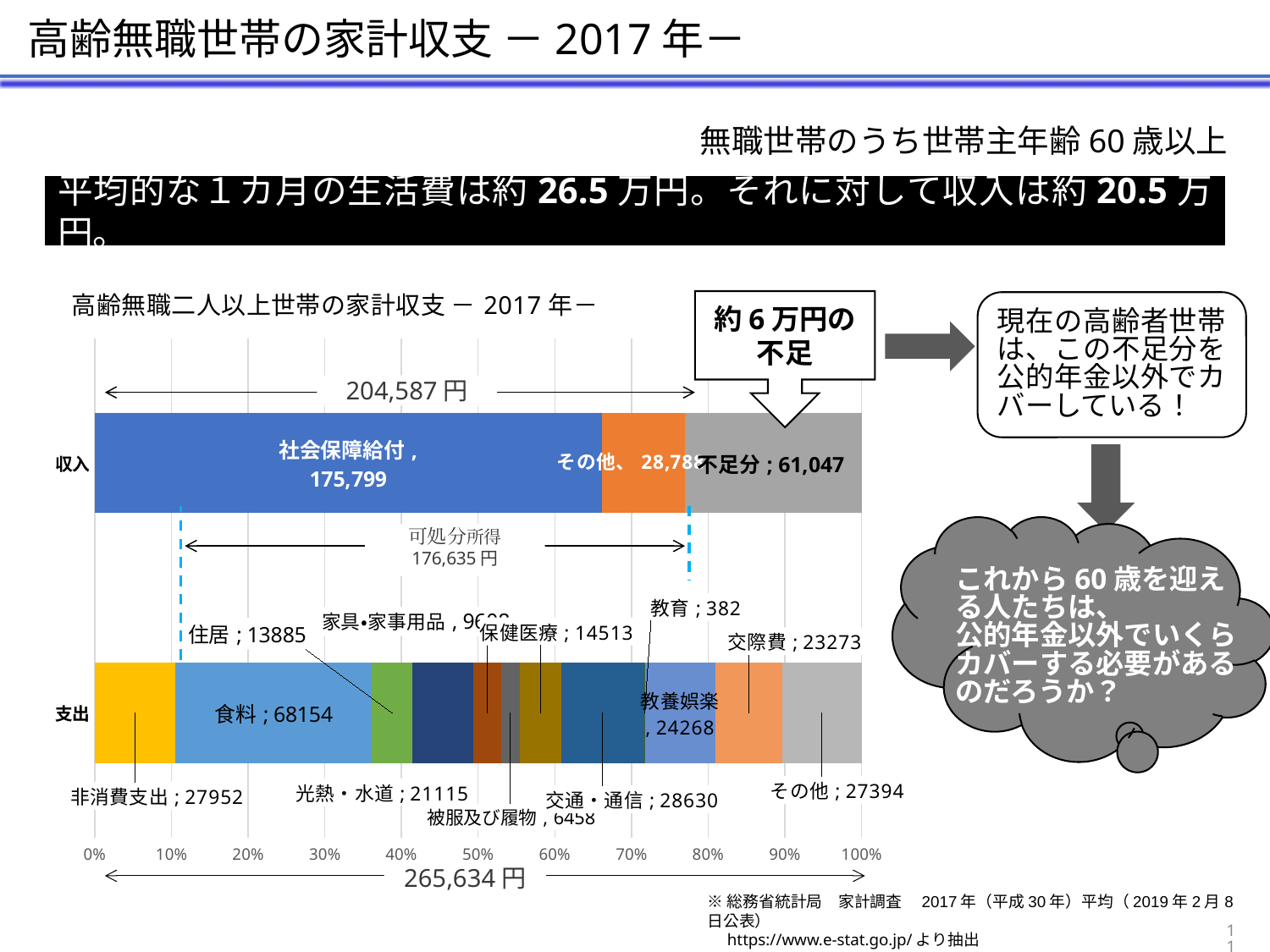
What is the difference between 交際費 and 光熱・水道 in the 支出 bar? 2158 What is the value of その他 in the 収入 bar? 28,788 How many bars (categories) does the chart have? 2 What kind of chart is shown on the slide? Stacked bar chart What is the value of 食料 in the 支出 bar? 68154 What is the value of 教育 in the 支出 bar? 382 What is the total of the 支出 bar as printed on the slide? 265,634 円 In the 支出 bar, which is larger: 交通・通信 or その他? 交通・通信 What is the value of 社会保障給付 in the 収入 bar? 175,799 What is the value of 不足分 in the 収入 bar? 61,047 Which segment of the 支出 bar has the largest value? 食料 Which segment of the 支出 bar has the smallest value? 教育